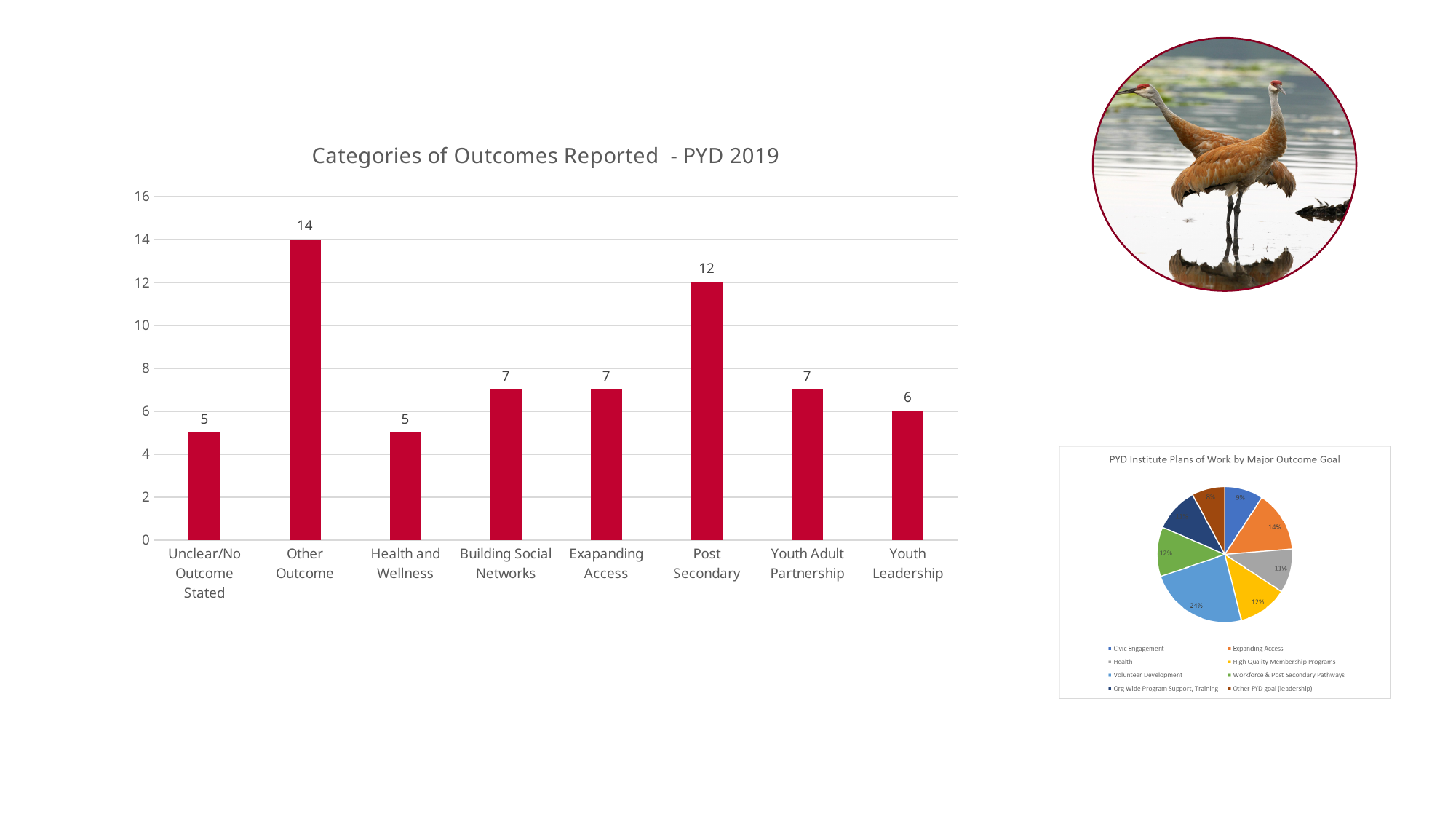
What kind of chart is 'PYD Institute Plans of Work by Major Outcome Goal'? pie chart In the bar chart 'Categories of Outcomes Reported - PYD 2019', what is the difference between Building Social Networks and Youth Leadership? 1 In the bar chart 'Categories of Outcomes Reported - PYD 2019', what is the value for Other Outcome? 14 In the bar chart 'Categories of Outcomes Reported - PYD 2019', what is the difference between Other Outcome and Post Secondary? 2 In the pie chart 'PYD Institute Plans of Work by Major Outcome Goal', how many entries does the legend list? 8 What kind of chart is 'Categories of Outcomes Reported - PYD 2019'? bar chart In the bar chart 'Categories of Outcomes Reported - PYD 2019', what is the value for Health and Wellness? 5 In the bar chart 'Categories of Outcomes Reported - PYD 2019', which category has the highest value? Other Outcome In the bar chart 'Categories of Outcomes Reported - PYD 2019', what is the value for Post Secondary? 12 In the bar chart 'Categories of Outcomes Reported - PYD 2019', what is the value for Youth Leadership? 6 In the bar chart 'Categories of Outcomes Reported - PYD 2019', how many categories are shown? 8 In the bar chart 'Categories of Outcomes Reported - PYD 2019', which is larger: Post Secondary or Youth Leadership? Post Secondary